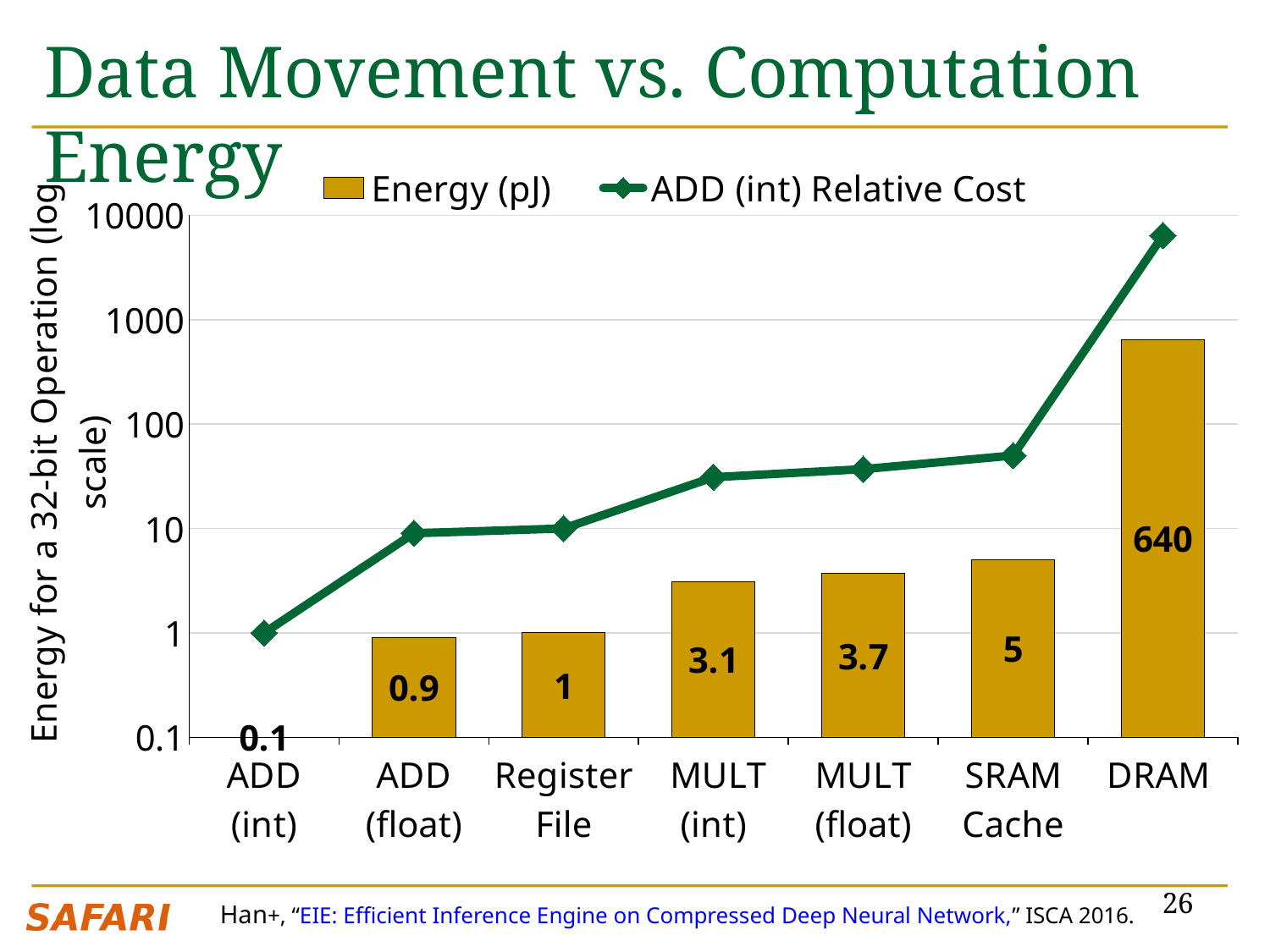
What is the difference in Energy (pJ) between DRAM and SRAM Cache? 635 Which category has the lowest Energy (pJ) value? ADD (int) What is the Energy (pJ) value for SRAM Cache? 5 How many series does the legend list? 2 Which category has the highest Energy (pJ) value? DRAM Is the ADD (int) Relative Cost value for DRAM greater or less than 1000? greater Do the Energy (pJ) values rise or fall from ADD (int) to DRAM along the x axis? rise Which has a larger Energy (pJ) value, MULT (int) or ADD (float)? MULT (int) How many categories are shown on the x axis? 7 What is the Energy (pJ) value for MULT (float)? 3.7 Is the ADD (int) Relative Cost value for SRAM Cache greater or less than 100? less What is the Energy (pJ) value for DRAM? 640